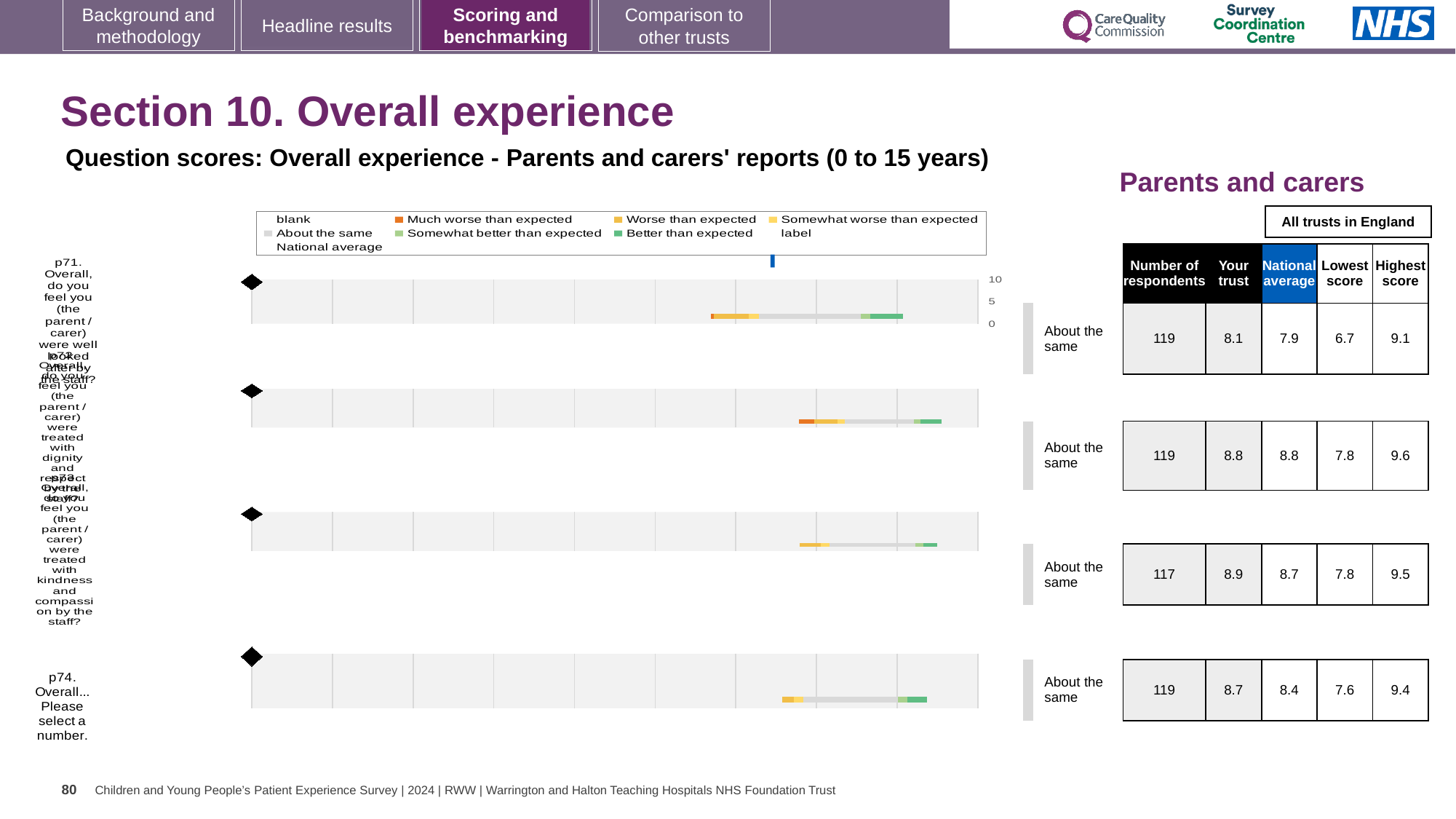
How many question bars (p71 to p74) are plotted in the chart? 4 In the table beside the chart, which question has the highest 'Your trust' score? p73 In the table beside the chart, is the 'Your trust' score for p71 larger or smaller than the national average for p71? larger In the table beside the chart, which question has the lowest 'Your trust' score? p71 In the table beside the chart, what is the highest score for the fourth question (p74)? 9.4 What is the subtitle printed above the chart? Question scores: Overall experience - Parents and carers' reports (0 to 15 years) In the table beside the chart, what is the national average for the second question (p72)? 8.8 In the table beside the chart, what is the difference between the 'Your trust' score and the national average for the fourth question (p74)? 0.3 How many entries does the chart legend list? 9 In the table beside the chart, what is the 'Your trust' score for the first question (p71)? 8.1 Which colour does the legend use for 'Much worse than expected'? orange What kind of chart is used to show the question scores on this slide? bar chart